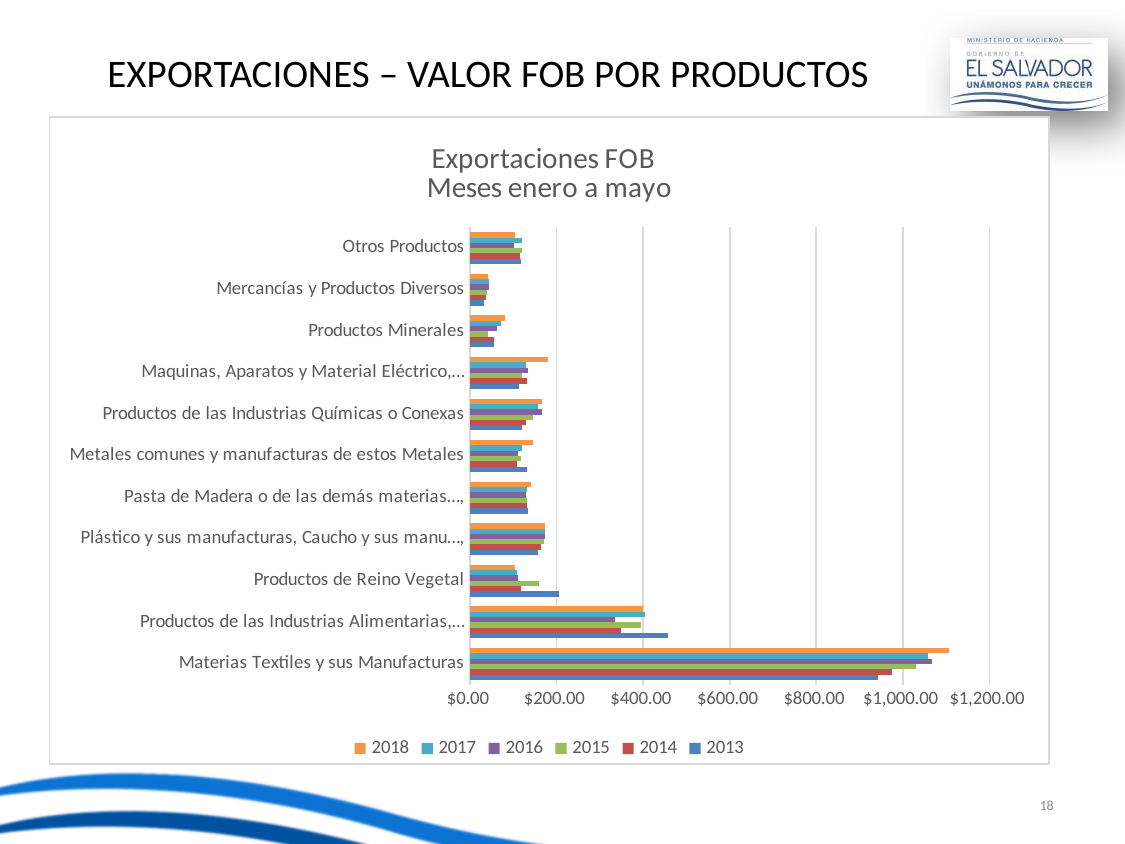
What is the title of the chart? Exportaciones FOB Meses enero a mayo Is the 2013 value for Materias Textiles y sus Manufacturas greater or less than $1,000.00? less How many series does the legend list? 6 Which product category has the highest export value in 2018? Materias Textiles y sus Manufacturas What kind of chart is shown on the slide? bar chart Which product category has the lowest export values across the years shown? Mercancías y Productos Diversos How many product categories are plotted on the chart? 11 Is the 2018 value for Mercancías y Productos Diversos greater or less than $200.00? less Is the 2018 value for Materias Textiles y sus Manufacturas greater or less than $1,000.00? greater For Productos de Reino Vegetal, which year has the larger value, 2013 or 2018? 2013 For Productos de las Industrias Alimentarias, which year has the larger value, 2013 or 2014? 2013